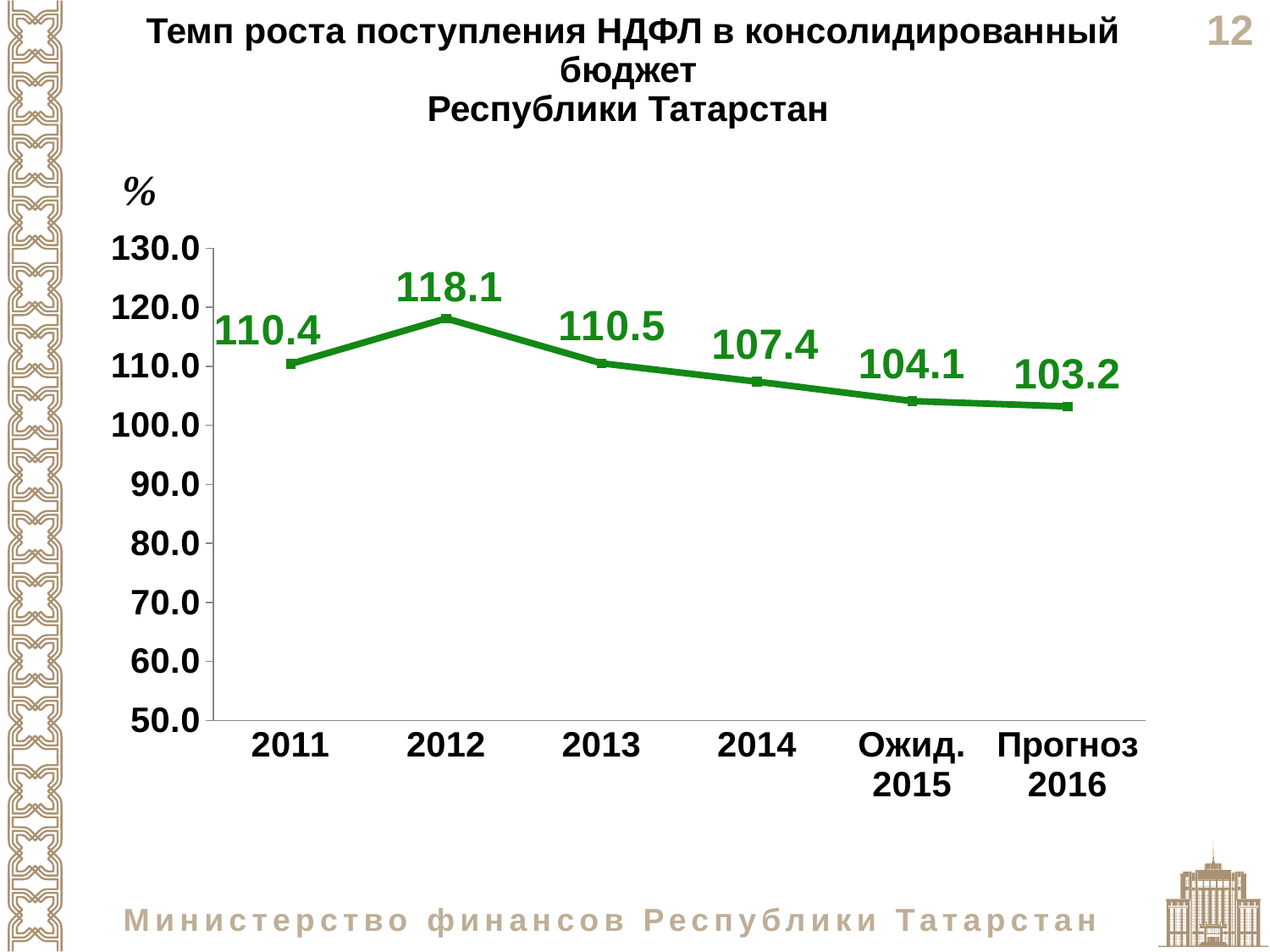
Which is larger, the value for 2011 or the value for 2014? 2011 What is the difference between the values for 2014 and Ожид. 2015? 3.3 Which year has the highest value? 2012 What is the value for Ожид. 2015? 104.1 What is the difference between the values for 2012 and 2013? 7.6 Which category has the lowest value? Прогноз 2016 Is the value for 2012 greater or less than 110.0? greater Do the values rise or fall from 2012 to Прогноз 2016? fall What is the value for Прогноз 2016? 103.2 What is the value for 2012? 118.1 How many data points are plotted on the chart? 6 What kind of chart is shown on the slide? line chart